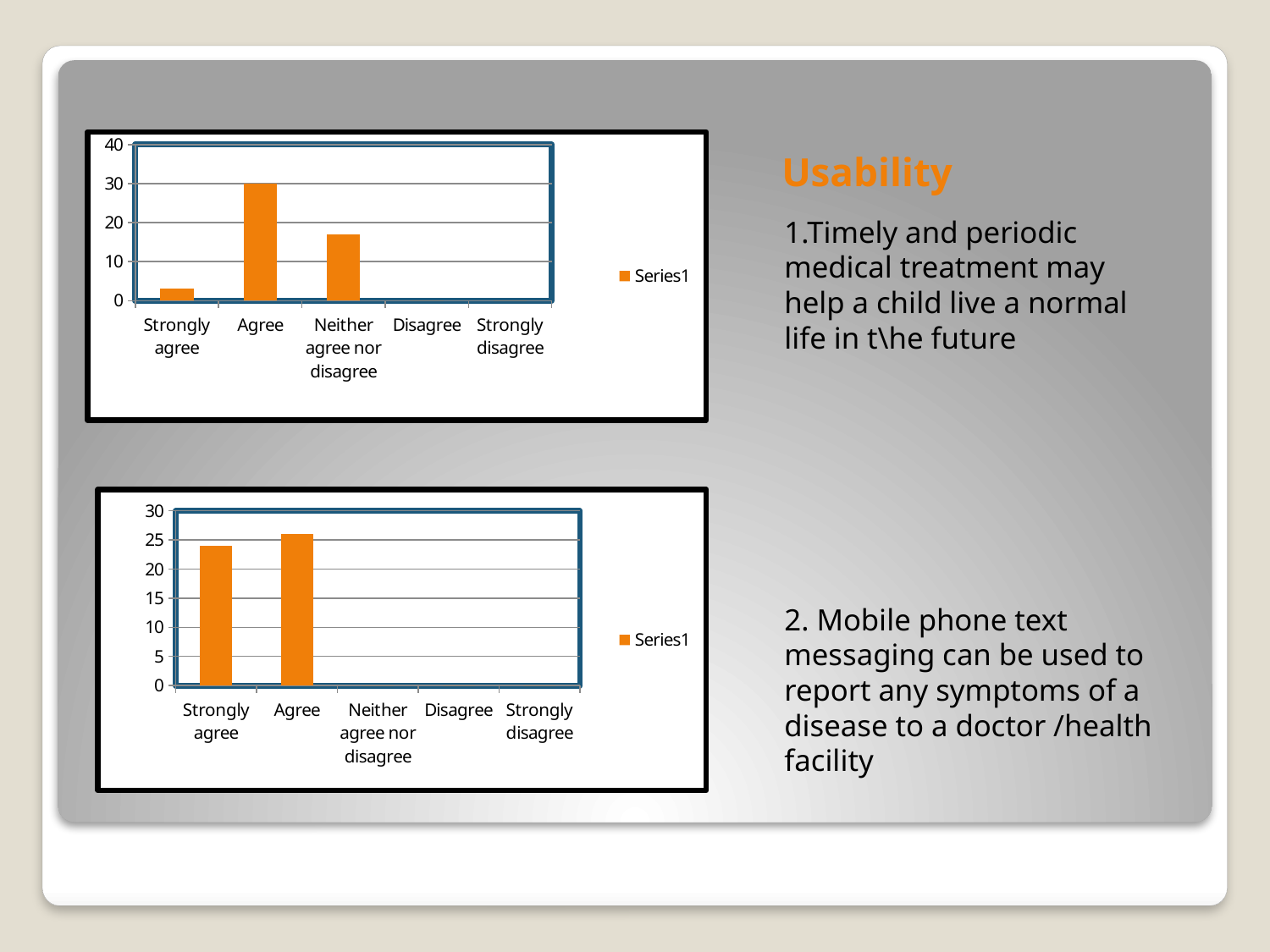
In the top chart, what is the value for Agree? 30 How many categories are shown on the x axis of the top chart? 5 What is the name of the series shown in the legend of the top chart? Series1 In the top chart, which is larger, the value for Agree or the value for Neither agree nor disagree? Agree In the top chart, which category has the highest value? Agree In the bottom chart, which category has the highest value? Agree In the top chart, is the value for Strongly agree greater or less than 10? less What kind of chart is the top chart on the slide? bar chart In the top chart, is the value for Neither agree nor disagree greater or less than 10? greater In the bottom chart, is the value for Strongly agree greater or less than 20? greater How many series does the legend of the bottom chart list? 1 In the bottom chart, which is larger, the value for Strongly agree or the value for Disagree? Strongly agree